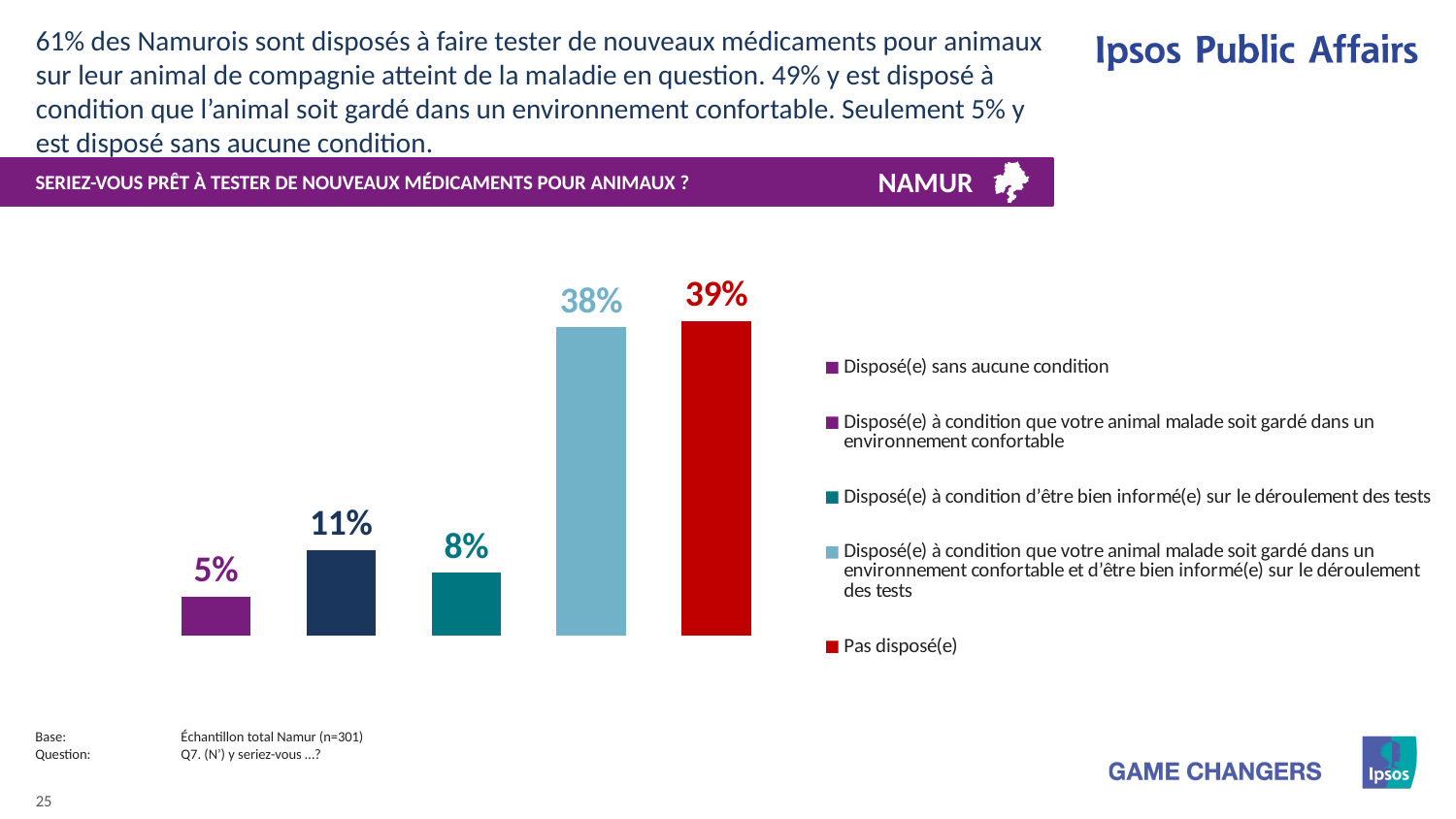
What is the difference between the 'Pas disposé(e)' value and the 'Disposé(e) sans aucune condition' value? 34 percentage points What percentage of respondents are 'Disposé(e) à condition que votre animal malade soit gardé dans un environnement confortable et d'être bien informé(e) sur le déroulement des tests'? 38% Which category has the highest value in the chart? Pas disposé(e) What percentage of respondents are 'Pas disposé(e)'? 39% What percentage of respondents are 'Disposé(e) à condition d'être bien informé(e) sur le déroulement des tests'? 8% Which category has the lowest value in the chart? Disposé(e) sans aucune condition What is the difference between the value for 'Disposé(e) à condition que votre animal malade soit gardé dans un environnement confortable' and the value for 'Disposé(e) à condition d'être bien informé(e) sur le déroulement des tests'? 3 percentage points Which is larger: the value for 'Disposé(e) à condition que votre animal malade soit gardé dans un environnement confortable' or the value for 'Disposé(e) à condition d'être bien informé(e) sur le déroulement des tests'? Disposé(e) à condition que votre animal malade soit gardé dans un environnement confortable How many entries does the legend list? 5 What percentage of respondents are 'Disposé(e) sans aucune condition'? 5% What kind of chart is shown on the slide? Bar chart How many bars are plotted in the chart? 5